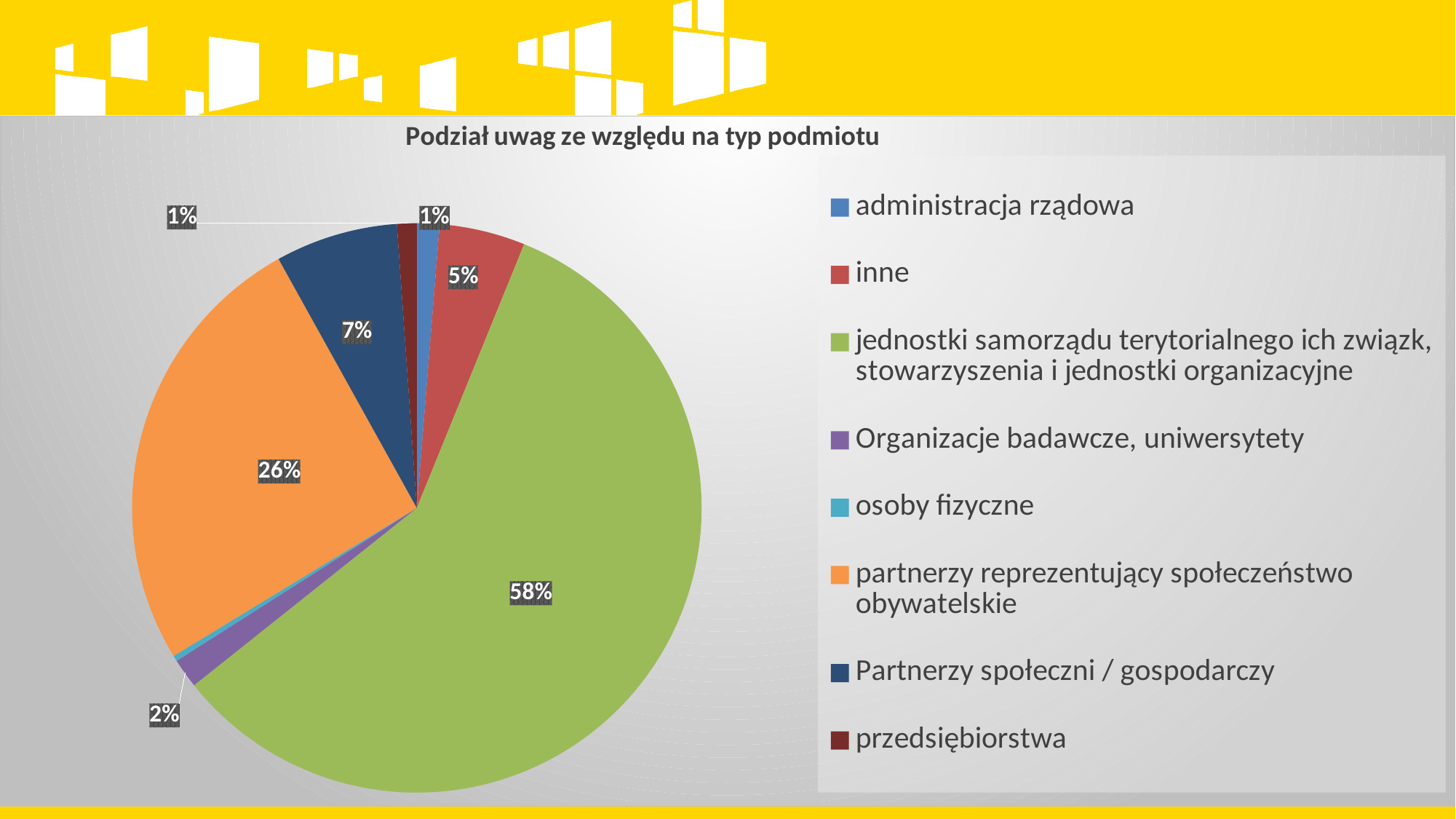
What percentage is shown for 'partnerzy reprezentujący społeczeństwo obywatelskie'? 26% What percentage is shown for 'Organizacje badawcze, uniwersytety'? 2% What percentage is shown for 'inne'? 5% What kind of chart is shown on the slide? pie chart What percentage is shown for 'administracja rządowa'? 1% How many categories are listed in the legend? 8 Which has a larger share: 'inne' or 'Partnerzy społeczni / gospodarczy'? Partnerzy społeczni / gospodarczy What is the difference in percentage points between the largest slice (58%) and the 'partnerzy reprezentujący społeczeństwo obywatelskie' slice (26%)? 32 What percentage is shown for 'Partnerzy społeczni / gospodarczy'? 7% Which category has the largest share of the pie? jednostki samorządu terytorialnego ich związk, stowarzyszenia i jednostki organizacyjne What is the title of the chart? Podział uwag ze względu na typ podmiotu What share of the pie does 'jednostki samorządu terytorialnego ich związk, stowarzyszenia i jednostki organizacyjne' have? 58%